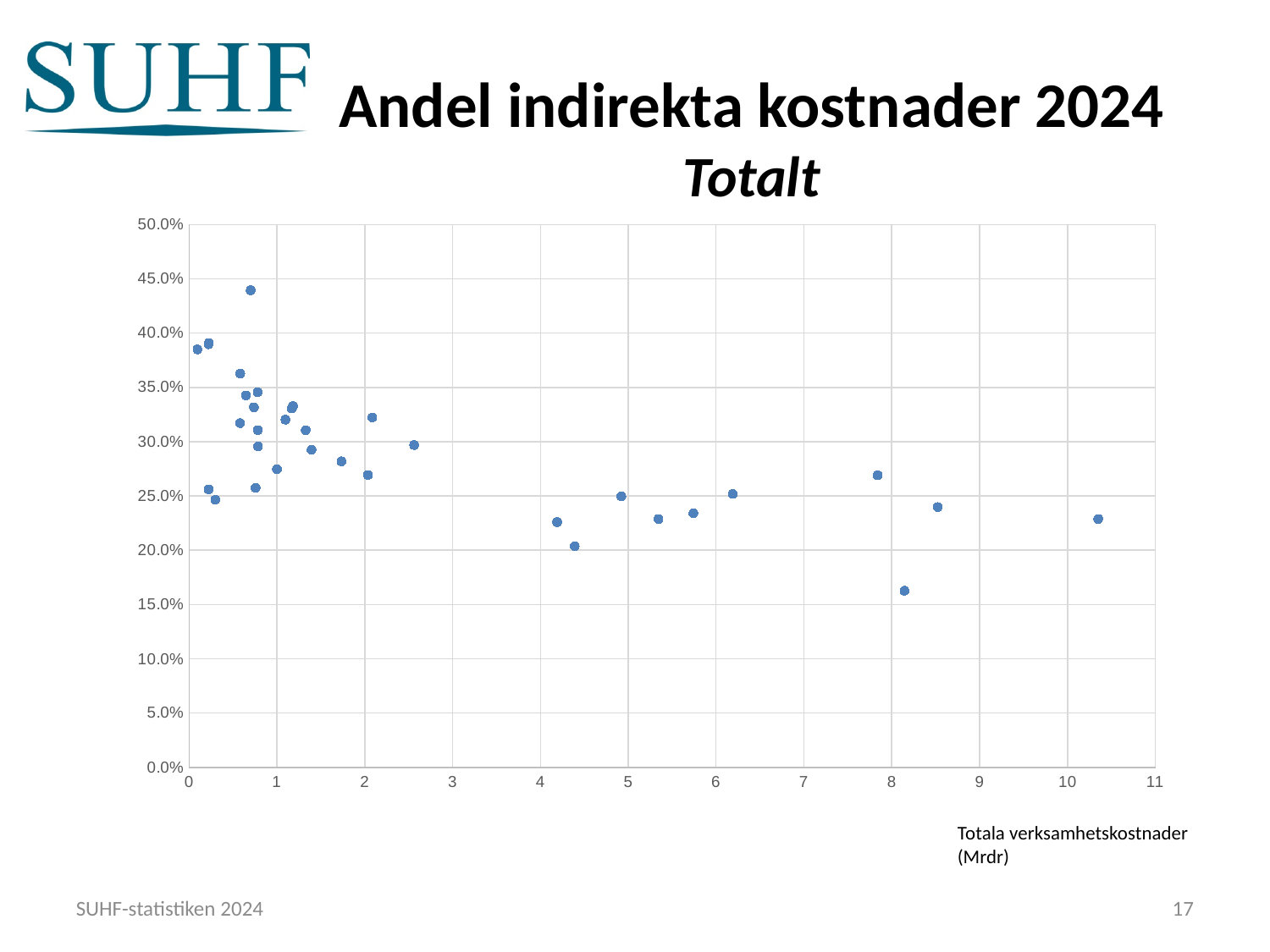
Which has the lower value: the point near 8.1 on the x axis or the point near 8.5 on the x axis? the point near 8.1 Is the value of the lowest point on the chart greater or less than 20.0%? less What is the label of the x axis? Totala verksamhetskostnader (Mrdr) Do the plotted values generally rise or fall as the x-axis value increases? fall Is the value of the point near 4.4 on the x axis greater or less than 25.0%? less Is the value of the highest point on the chart greater or less than 40.0%? greater What is the title of the chart? Andel indirekta kostnader 2024 Totalt What kind of chart is shown on the slide? scatter chart Which has the higher value: the highest point below 1 on the x axis or the rightmost point near 10 on the x axis? the highest point below 1 on the x axis